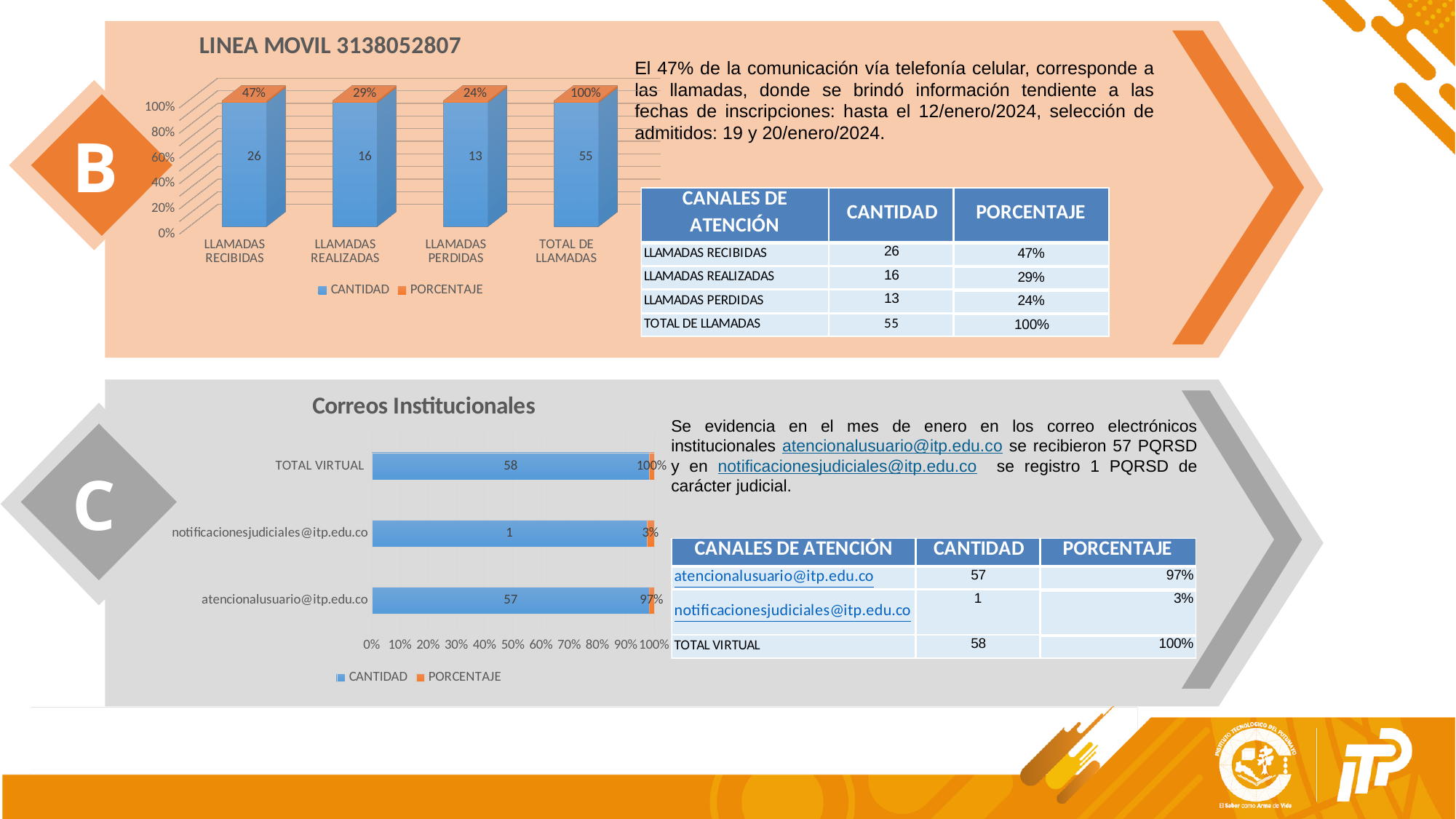
In the 'Correos Institucionales' chart, which category has the highest CANTIDAD value? TOTAL VIRTUAL In the 'LINEA MOVIL 3138052807' chart, what is the difference between the CANTIDAD values for LLAMADAS RECIBIDAS and LLAMADAS REALIZADAS? 10 What kind of chart is 'Correos Institucionales'? Bar chart In the 'Correos Institucionales' chart, what colour represents the PORCENTAJE series in the legend? Orange In the 'LINEA MOVIL 3138052807' chart, what is the CANTIDAD value for LLAMADAS RECIBIDAS? 26 In the 'LINEA MOVIL 3138052807' chart, what PORCENTAJE is shown for LLAMADAS PERDIDAS? 24% In the 'Correos Institucionales' chart, which has a larger CANTIDAD value: atencionalusuario@itp.edu.co or notificacionesjudiciales@itp.edu.co? atencionalusuario@itp.edu.co In the 'Correos Institucionales' chart, what is the CANTIDAD value for atencionalusuario@itp.edu.co? 57 In the 'LINEA MOVIL 3138052807' chart, how many series does the legend list? 2 In the 'LINEA MOVIL 3138052807' chart, which category has the lowest CANTIDAD value? LLAMADAS PERDIDAS In the 'Correos Institucionales' chart, what PORCENTAJE is shown for notificacionesjudiciales@itp.edu.co? 3% In the 'LINEA MOVIL 3138052807' chart, how many categories are shown on the x axis? 4